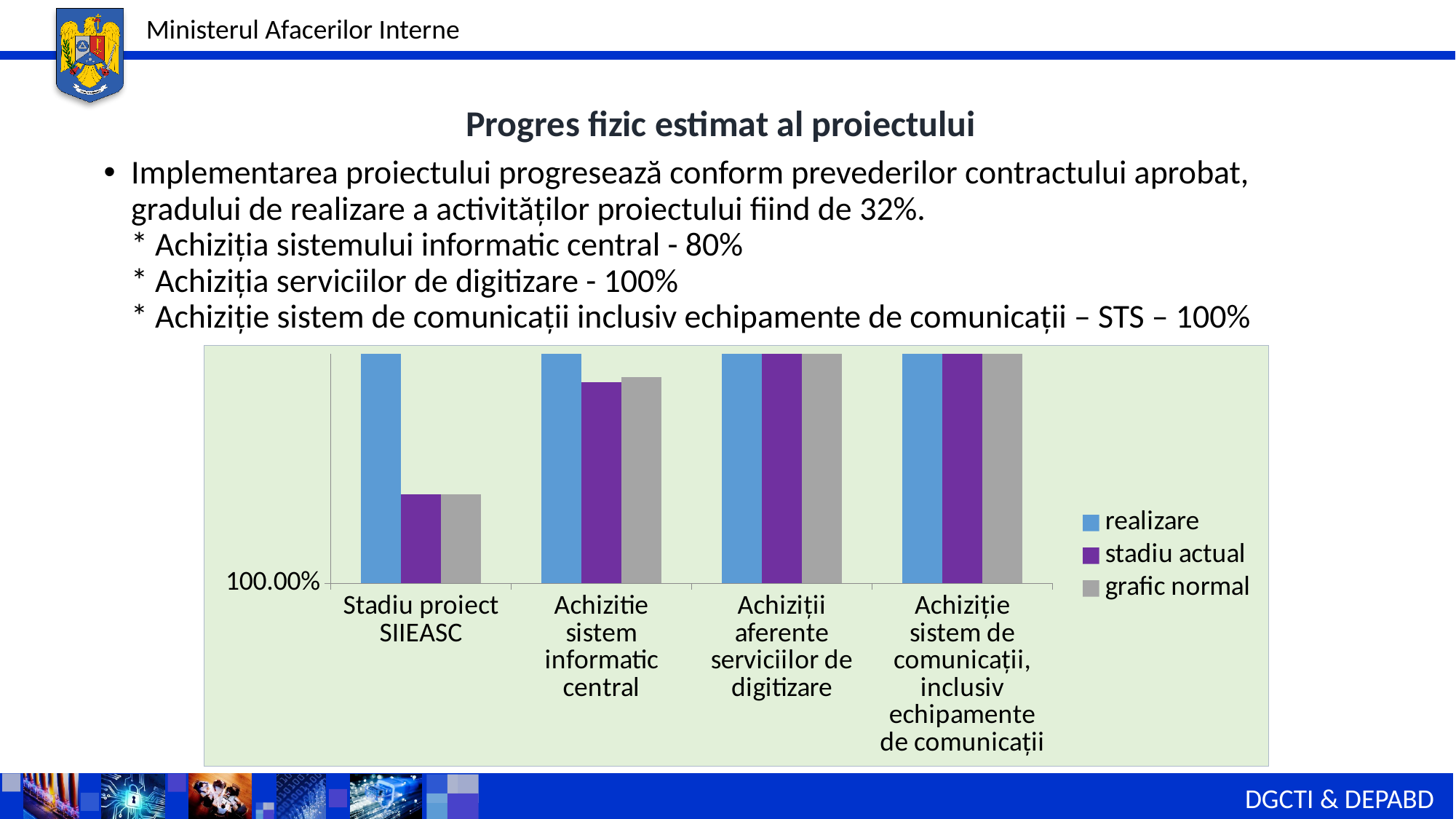
Which has the larger 'stadiu actual' value: 'Achizitie sistem informatic central' or 'Stadiu proiect SIIEASC'? Achizitie sistem informatic central Does the 'stadiu actual' series rise or fall from 'Stadiu proiect SIIEASC' to 'Achiziții aferente serviciilor de digitizare'? rise Which category has the lowest 'stadiu actual' value? Stadiu proiect SIIEASC What kind of chart is shown on the slide? bar chart How many categories are shown on the x axis of the chart? 4 Which category has the lowest 'grafic normal' value? Stadiu proiect SIIEASC For 'Stadiu proiect SIIEASC', which is larger: 'realizare' or 'stadiu actual'? realizare What are the three series listed in the chart's legend? realizare, stadiu actual, grafic normal Which has the larger 'stadiu actual' value: 'Stadiu proiect SIIEASC' or 'Achiziții aferente serviciilor de digitizare'? Achiziții aferente serviciilor de digitizare How many series does the chart's legend list? 3 Which colour represents the 'stadiu actual' series in the chart? purple